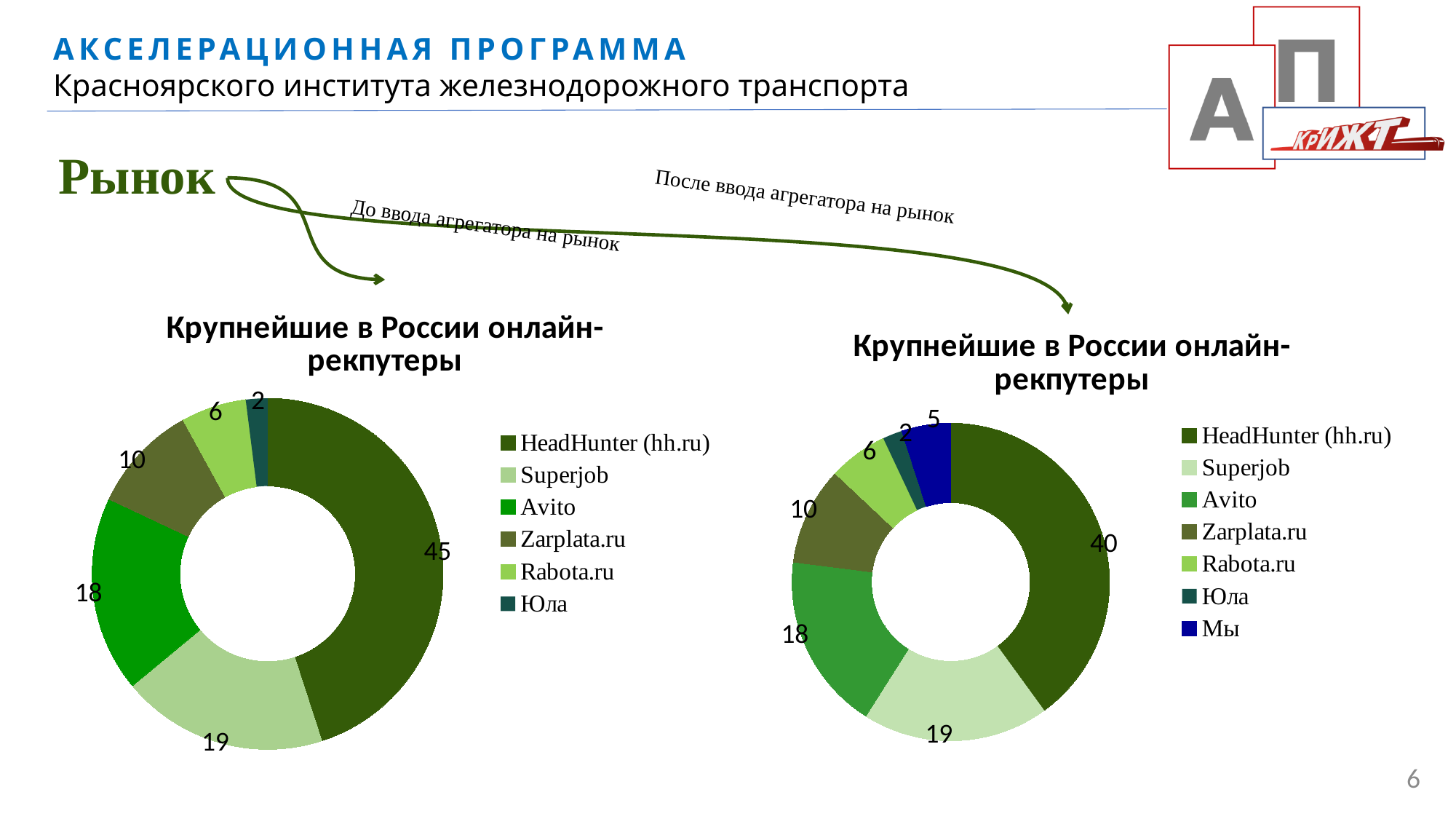
In the right chart, what is the value for Мы? 5 In the left chart, what share of the whole does HeadHunter (hh.ru) represent? 45% How many slices does the left chart have? 6 In the right chart, which category has the largest value? HeadHunter (hh.ru) What is the difference between the HeadHunter (hh.ru) value in the left chart and in the right chart? 5 In the right chart, which is larger: Zarplata.ru or Rabota.ru? Zarplata.ru What type of chart is the left chart on the slide? doughnut (pie) chart In the left chart, what is the difference between Superjob and Avito? 1 In the left chart, which category has the smallest value? Юла In the left chart, what is the value for HeadHunter (hh.ru)? 45 How many categories does the legend of the right chart list? 7 In the right chart, what is the value for HeadHunter (hh.ru)? 40